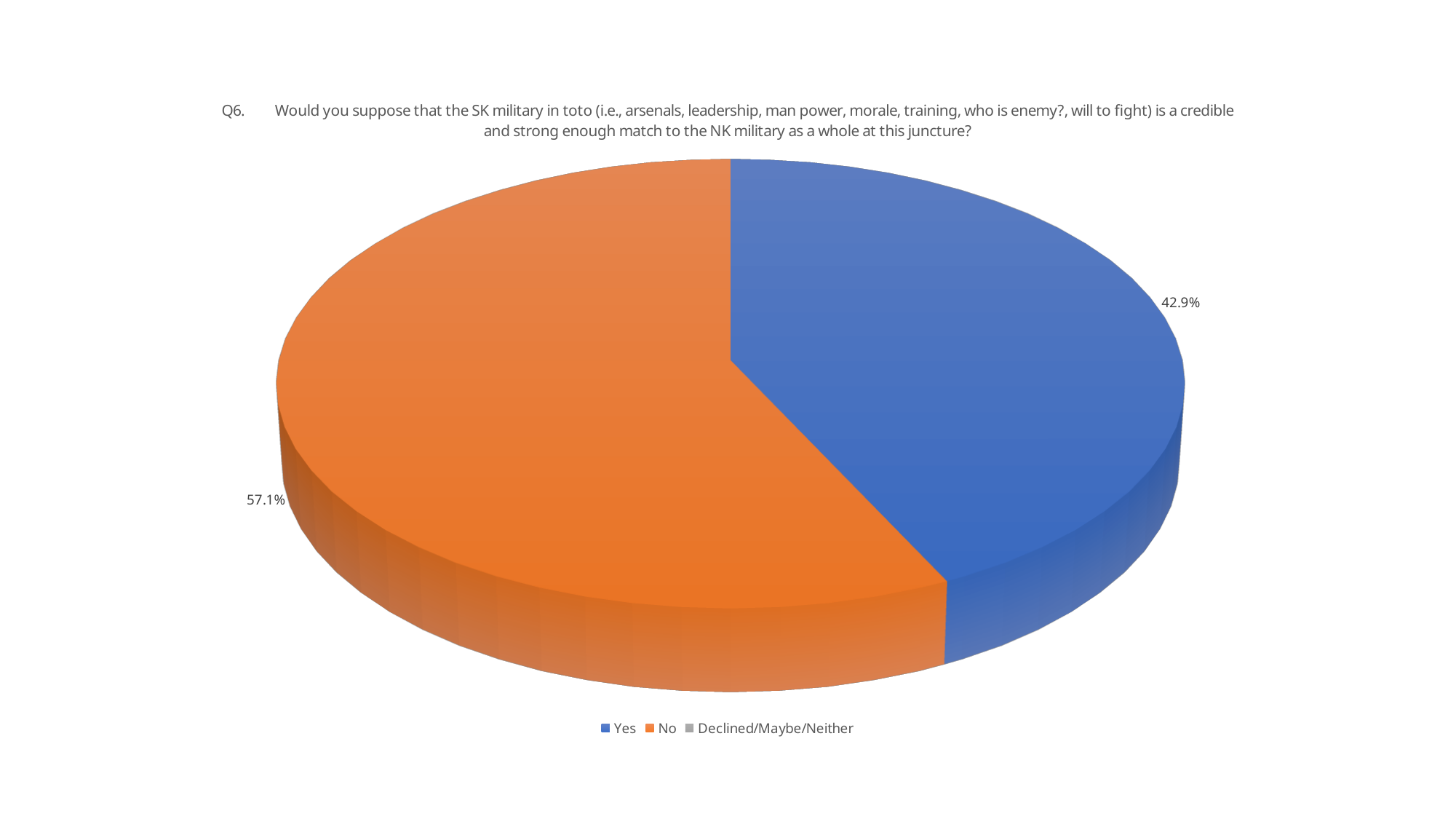
How many slices are visible in the pie? 2 Is the share for "No" larger or smaller than the share for "Yes"? larger What is the third legend entry, after Yes and No? Declined/Maybe/Neither Is the share for "Yes" greater or less than 50%? less What share of the pie is labelled for the "Yes" slice? 42.9% How many entries does the legend list? 3 What share of the pie is labelled for the "No" slice? 57.1% What kind of chart is shown on the slide? pie chart Which of the two visible slices, Yes or No, is smaller? Yes What is the difference in percentage points between the "No" share and the "Yes" share? 14.2 What colour is the "No" slice? orange Which response has the largest share of the pie? No